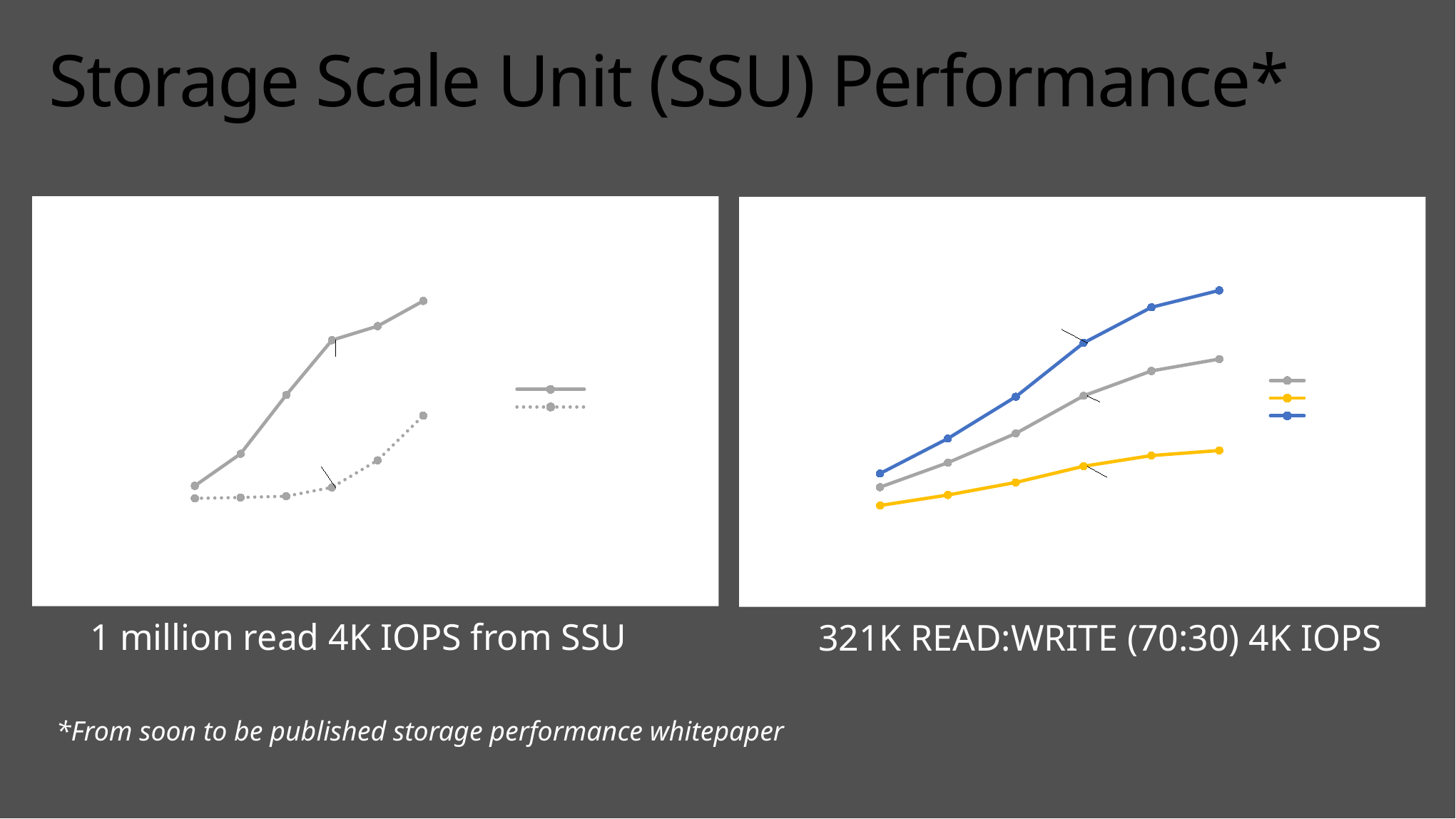
What caption appears below the left chart? 1 million read 4K IOPS from SSU What kind of chart is the right chart on the slide? line chart How many data points does the blue line in the right chart have? 6 How many series does the legend of the right chart list? 3 How many series does the legend of the left chart list? 2 What kind of chart is the left chart on the slide? line chart How many data points does the solid line in the left chart have? 6 In the right chart, do the values of the yellow line rise or fall from left to right? rise In the left chart, do the values of the solid line rise or fall from left to right? rise In the left chart, which line is higher at the rightmost point, the solid line or the dotted line? solid line What caption appears below the right chart? 321K READ:WRITE (70:30) 4K IOPS In the right chart, which line is higher at the rightmost point, the blue line or the yellow line? blue line